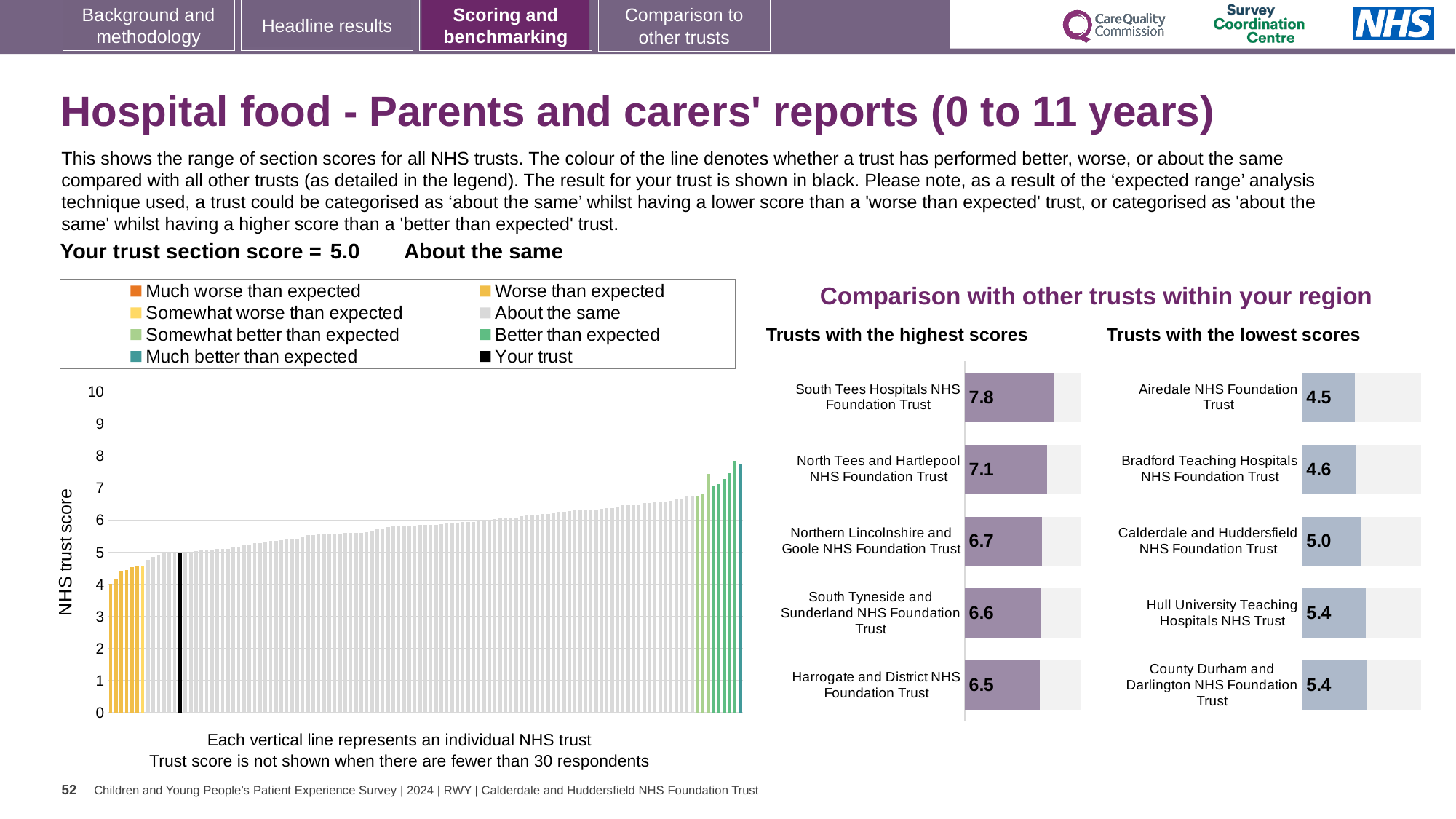
In the 'Trusts with the lowest scores' chart, what is the difference between the scores of Hull University Teaching Hospitals NHS Trust and Airedale NHS Foundation Trust? 0.9 In the 'Trusts with the highest scores' chart, what is the score for South Tees Hospitals NHS Foundation Trust? 7.8 In the main 'NHS trust score' chart, is the value of the tallest bar greater or less than 7? greater How many entries does the legend of the main 'NHS trust score' chart list? 8 In the 'Trusts with the lowest scores' chart, what is the score for Bradford Teaching Hospitals NHS Foundation Trust? 4.6 How many trusts are shown in the 'Trusts with the lowest scores' chart? 5 In the main 'NHS trust score' chart, do the bar values rise or fall from left to right? Rise In the 'Trusts with the lowest scores' chart, which trust has the lowest score? Airedale NHS Foundation Trust What kind of chart is the main chart on the left showing NHS trust scores? Bar chart In the 'Trusts with the highest scores' chart, what is the score for Harrogate and District NHS Foundation Trust? 6.5 In the 'Trusts with the highest scores' chart, which has the higher score: North Tees and Hartlepool NHS Foundation Trust or Northern Lincolnshire and Goole NHS Foundation Trust? North Tees and Hartlepool NHS Foundation Trust In the 'Trusts with the highest scores' chart, what is the difference between the scores of South Tees Hospitals NHS Foundation Trust and Harrogate and District NHS Foundation Trust? 1.3